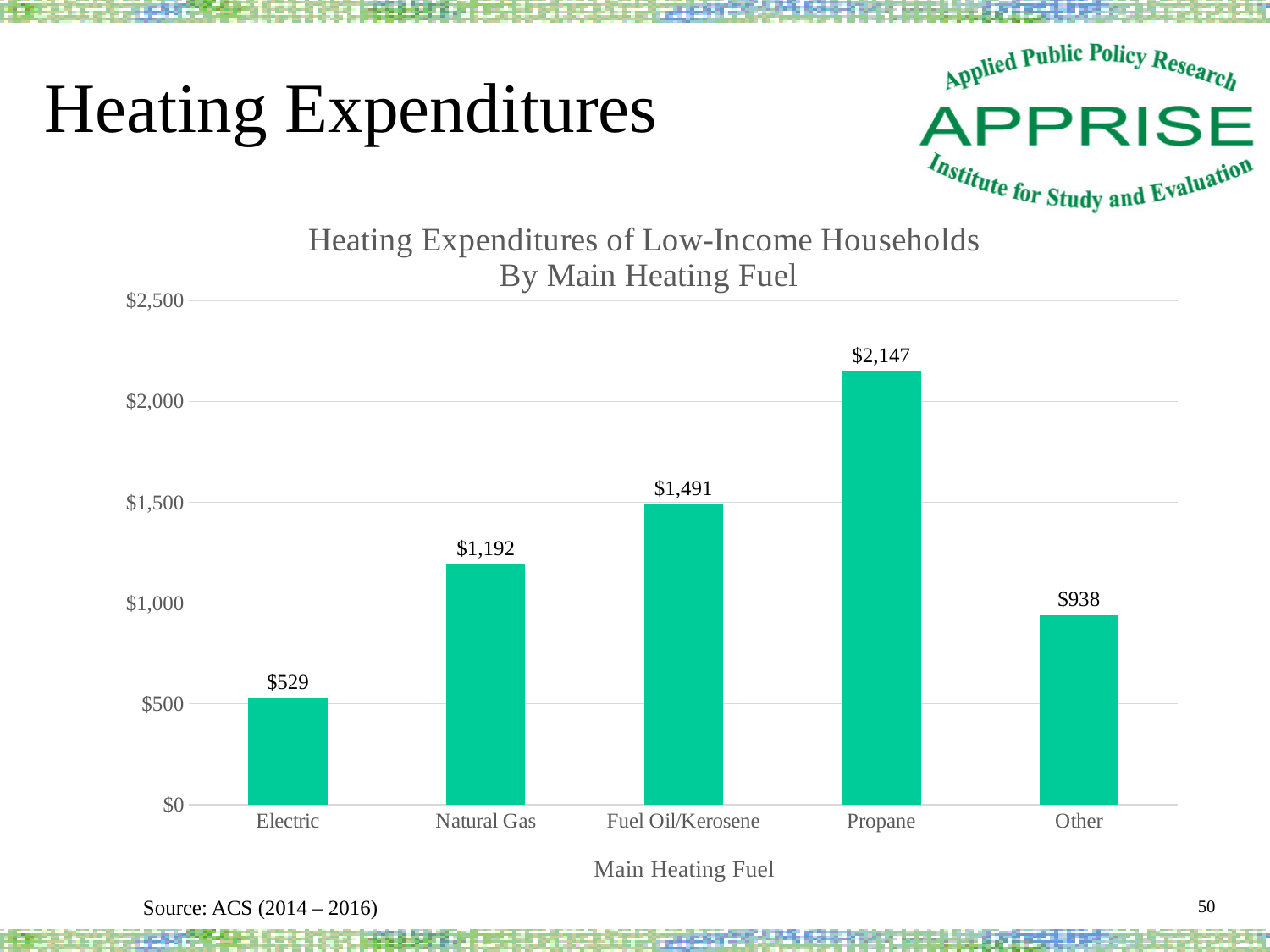
What kind of chart is shown on the slide? Bar chart What is the title of the chart? Heating Expenditures of Low-Income Households By Main Heating Fuel What is the heating expenditure for Fuel Oil/Kerosene? $1,491 What is the heating expenditure for Electric? $529 How many main heating fuel categories are shown in the chart? 5 What is the heating expenditure for Natural Gas? $1,192 Which main heating fuel has the lowest heating expenditure? Electric What is the difference between the heating expenditure for Propane and for Electric? $1,618 What is the heating expenditure for Other? $938 Which has a higher heating expenditure, Natural Gas or Other? Natural Gas What is the heating expenditure for Propane? $2,147 Which main heating fuel has the highest heating expenditure? Propane